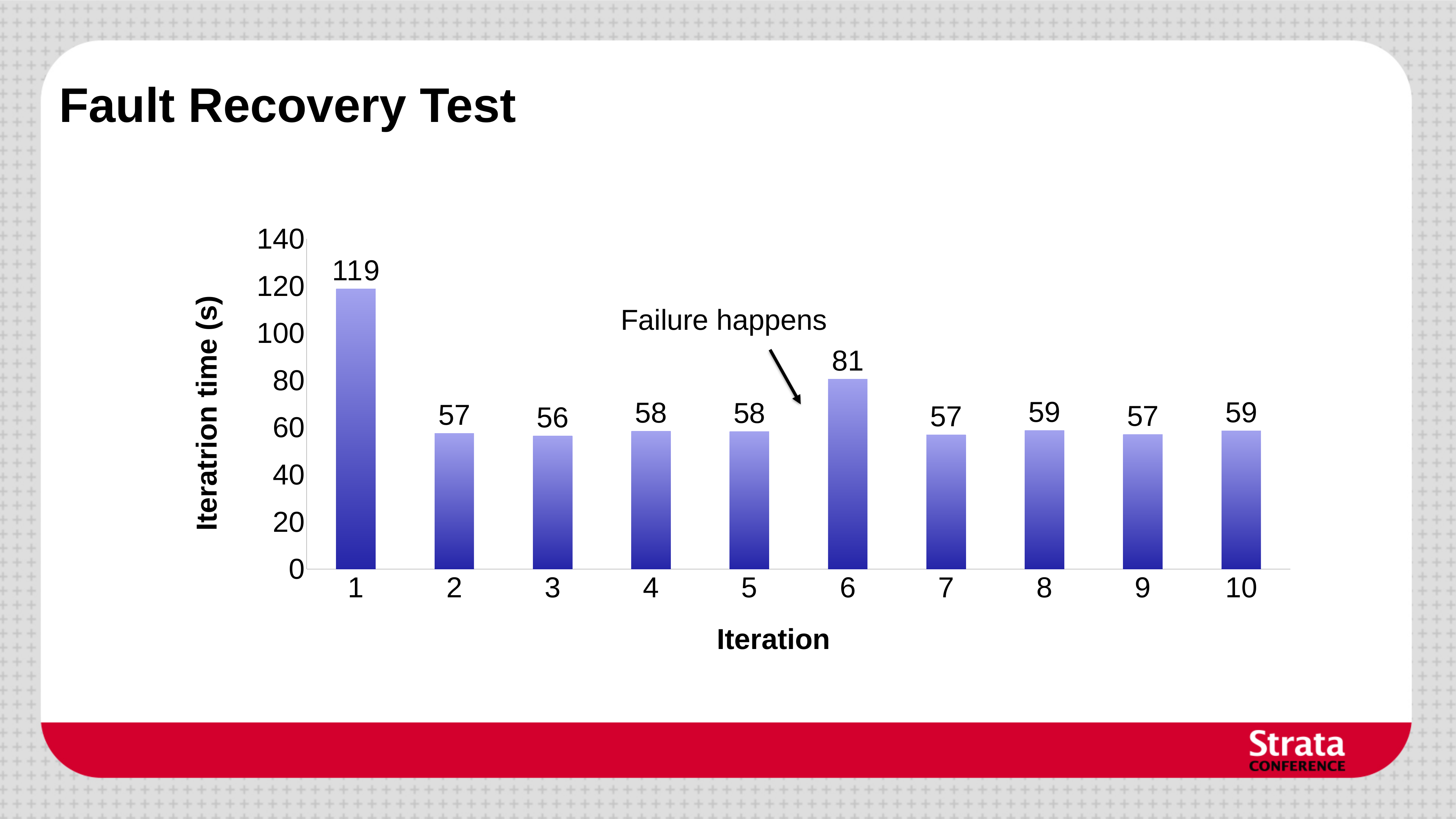
What is the difference in iteration time between iteration 6 and iteration 7? 24 What is the iteration time for iteration 6? 81 How many iterations are shown on the x axis? 10 What kind of chart is shown on the slide? Bar chart Which iteration has the highest iteration time? 1 Is the value for iteration 1 greater or less than 100? greater What is the iteration time for iteration 3? 56 What event does the annotation arrow on the chart point to? Failure happens What is the difference in iteration time between iteration 1 and iteration 2? 62 What is the iteration time for iteration 1? 119 Which iteration has the lowest iteration time? 3 Which has a larger iteration time, iteration 6 or iteration 8? Iteration 6